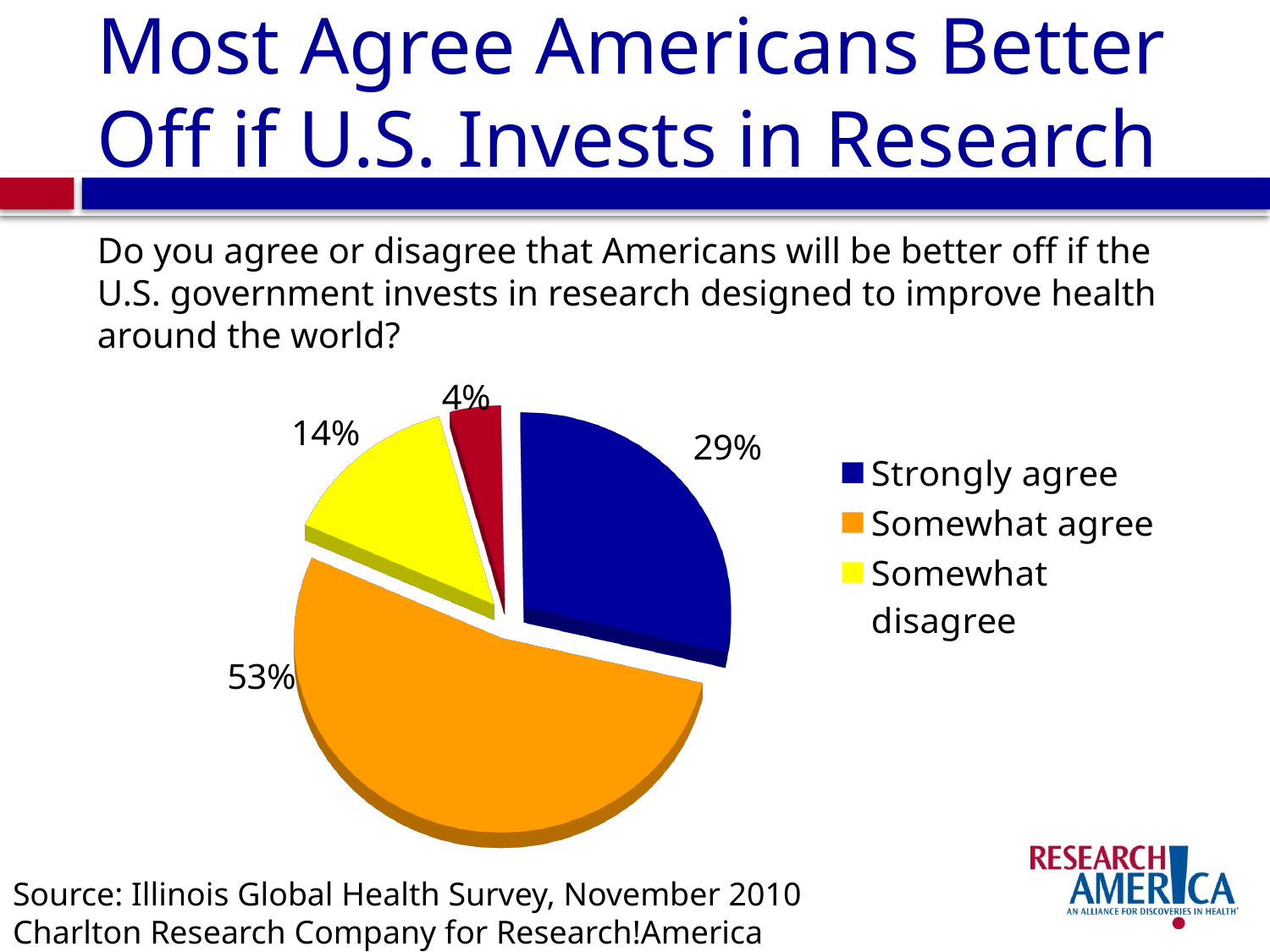
What percentage of respondents said they somewhat disagree? 14% Which response category has the largest slice of the pie? Somewhat agree What is the smallest percentage shown on the pie chart? 4% What kind of chart is shown on the slide? Pie chart What percentage of respondents said they somewhat agree? 53% What is the difference between the Somewhat agree and Strongly agree percentages? 24% What percentage of respondents said they strongly agree? 29% What colour is the Strongly agree slice? Blue How many slices does the pie chart have? 4 Which is larger, the Strongly agree slice or the Somewhat disagree slice? Strongly agree What is the difference between the Strongly agree and Somewhat disagree percentages? 15% How many entries does the legend list? 3